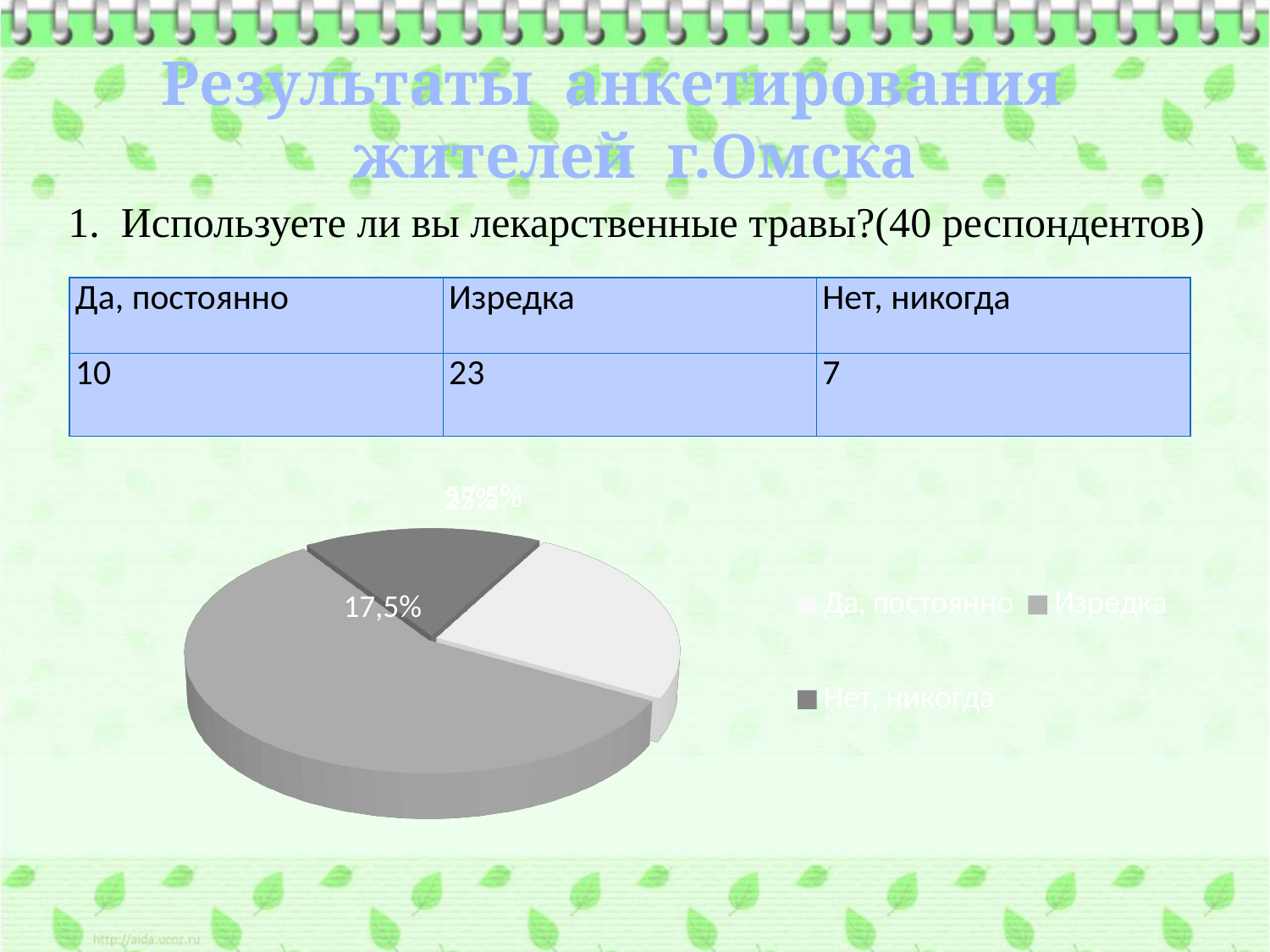
Which slice is larger in the pie chart: "Да, постоянно" or "Нет, никогда"? Да, постоянно Which category has the smallest slice in the pie chart? Нет, никогда Which legend entry is shown with the darkest colour in the pie chart? Нет, никогда Which slice is larger in the pie chart: "Изредка" or "Да, постоянно"? Изредка What percentage is shown for the "Нет, никогда" slice of the pie chart? 17,5% What share of the pie does the "Нет, никогда" slice represent? 17,5% What are the three legend entries of the pie chart? Да, постоянно; Изредка; Нет, никогда How many slices does the pie chart have? 3 Which category has the largest slice in the pie chart? Изредка How many entries does the chart legend list? 3 What kind of chart is shown on the slide? pie chart